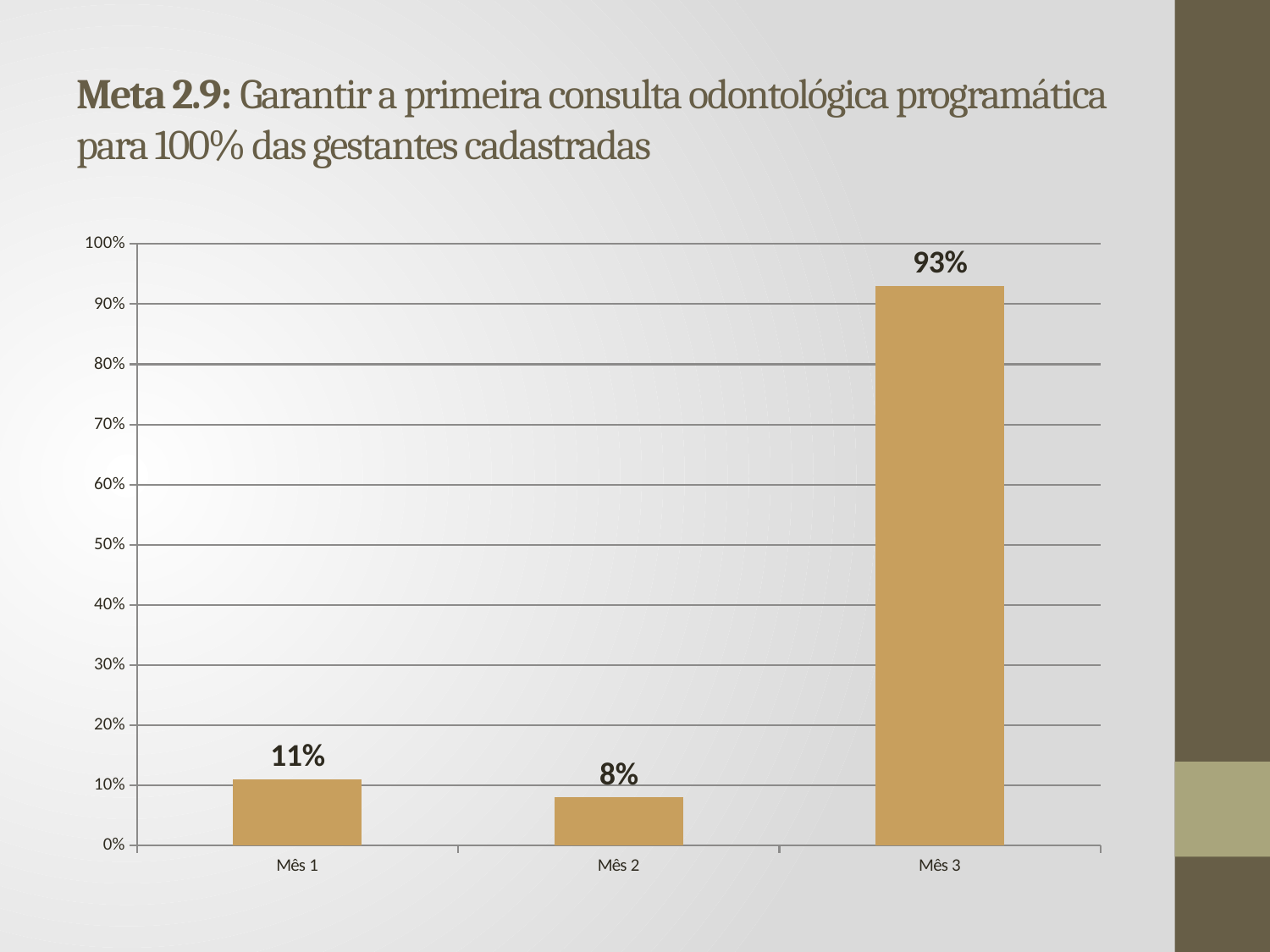
What kind of chart is shown on the slide? bar chart Is the value for Mês 3 greater or less than 90%? greater What is the difference between the values for Mês 1 and Mês 2? 3% What is the difference between the values for Mês 3 and Mês 1? 82% Which is larger, the value for Mês 1 or the value for Mês 2? Mês 1 What is the value for Mês 3? 93% What is the maximum value shown on the y axis? 100% What is the value for Mês 1? 11% How many categories are shown on the x axis? 3 Which month has the highest value? Mês 3 Which month has the lowest value? Mês 2 What is the value for Mês 2? 8%